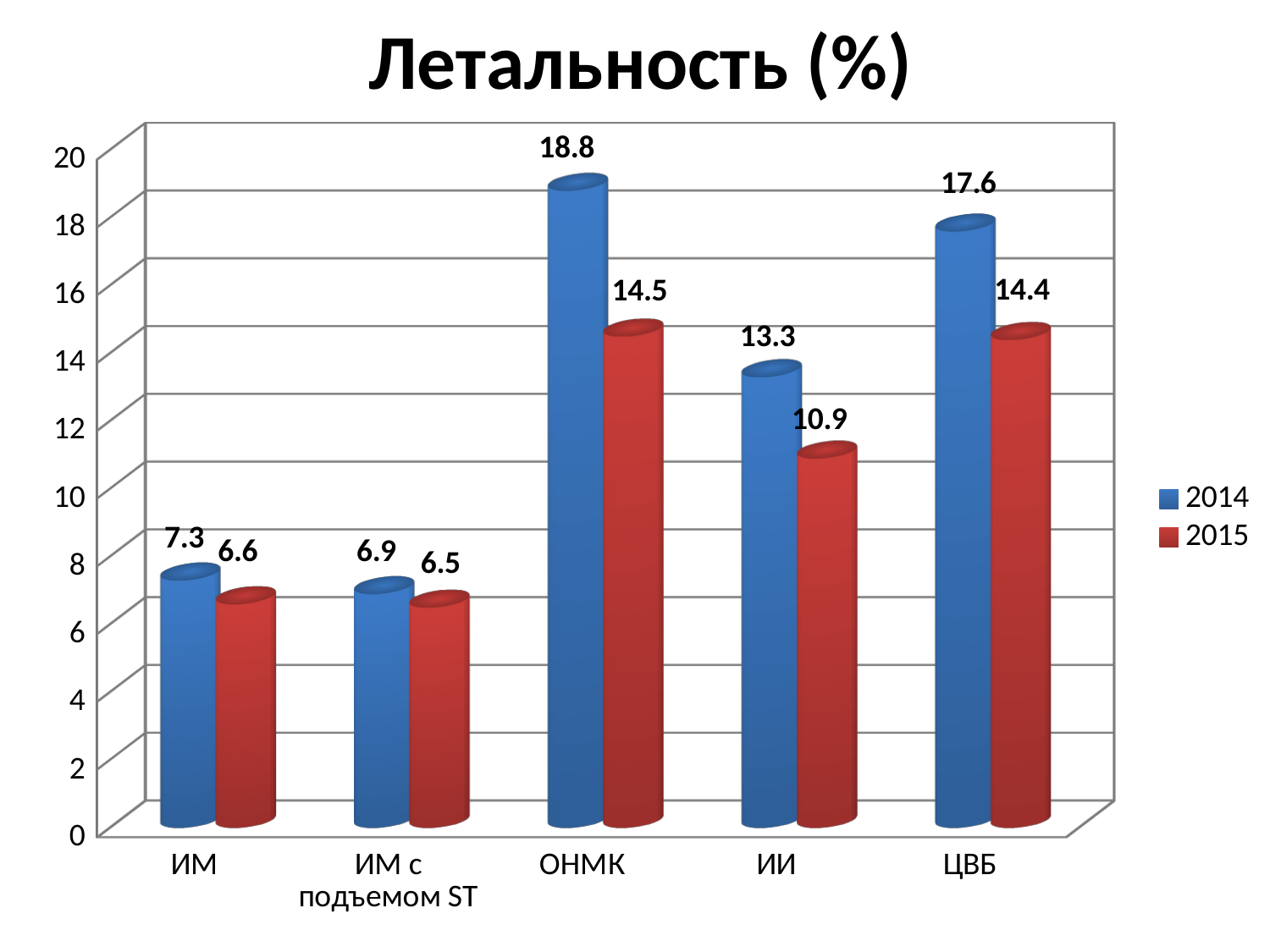
What is the 2014 value for ОНМК? 18.8 How many series does the legend list? 2 Which category has the lowest 2015 value? ИМ с подъемом ST What kind of chart is shown? Bar chart What is the title of the chart? Летальность (%) What is the difference between the 2014 and 2015 values for ОНМК? 4.3 What is the difference between the 2014 and 2015 values for ИИ? 2.4 How many categories are shown on the x axis? 5 Which is larger: the 2014 value for ЦВБ or the 2014 value for ИИ? 2014 value for ЦВБ Which category has the highest 2014 value? ОНМК What is the 2015 value for ЦВБ? 14.4 What is the 2015 value for ИМ с подъемом ST? 6.5